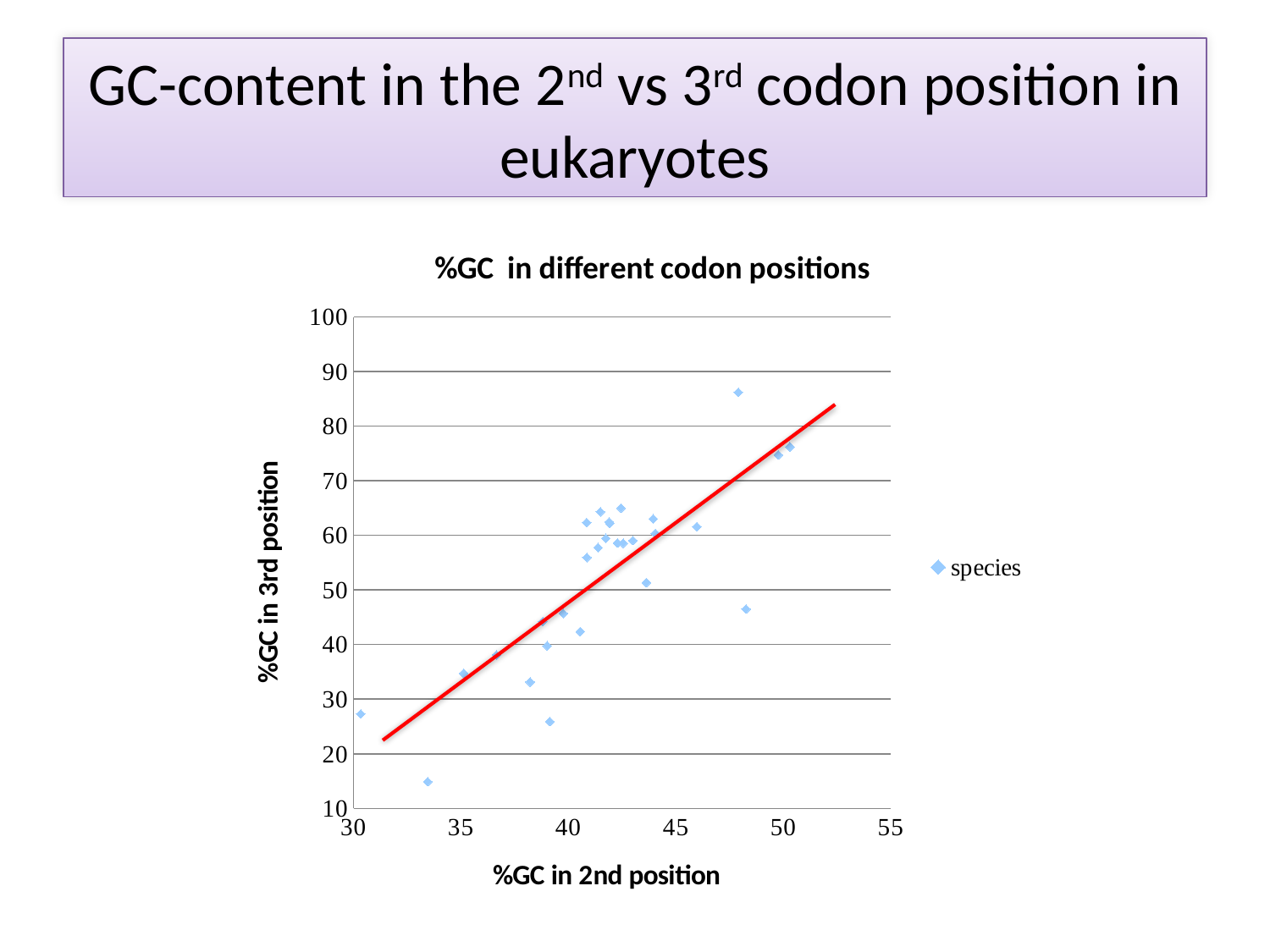
What series name is shown in the chart legend? species As %GC in 2nd position increases along the x axis, do the %GC in 3rd position values generally rise or fall? rise What is the title of the chart? %GC in different codon positions Is the %GC in 2nd position value of the lowest point on the chart greater or less than 35? less Does the red trend line slope upward or downward from left to right? upward Is the %GC in 2nd position value of the highest point on the chart greater or less than 45? greater How many series does the legend list? 1 Is the %GC in 3rd position value of the lowest point on the chart greater or less than 20? less What kind of chart is shown on the slide? scatter plot